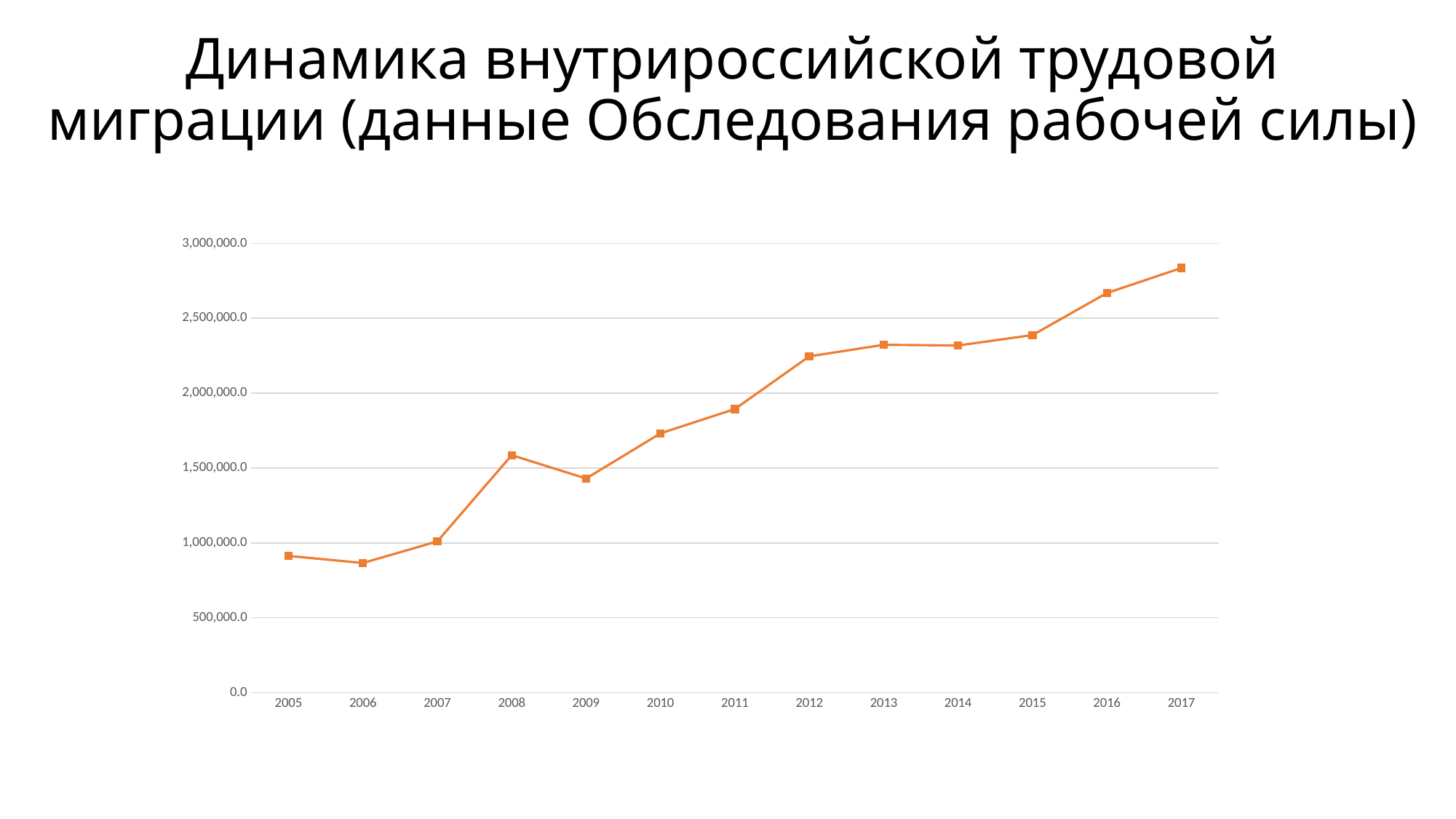
Which year has the highest value? 2017 Is the value for 2017 greater or less than 3,000,000.0? less Is the value for 2016 greater or less than 2,500,000.0? greater Is the value for 2005 greater or less than 1,000,000.0? less Overall, do the values rise or fall from 2005 to 2017? rise What kind of chart is shown on the slide? line chart Which year has the lowest value? 2006 Which year has the larger value, 2008 or 2009? 2008 How many years are plotted on the x axis? 13